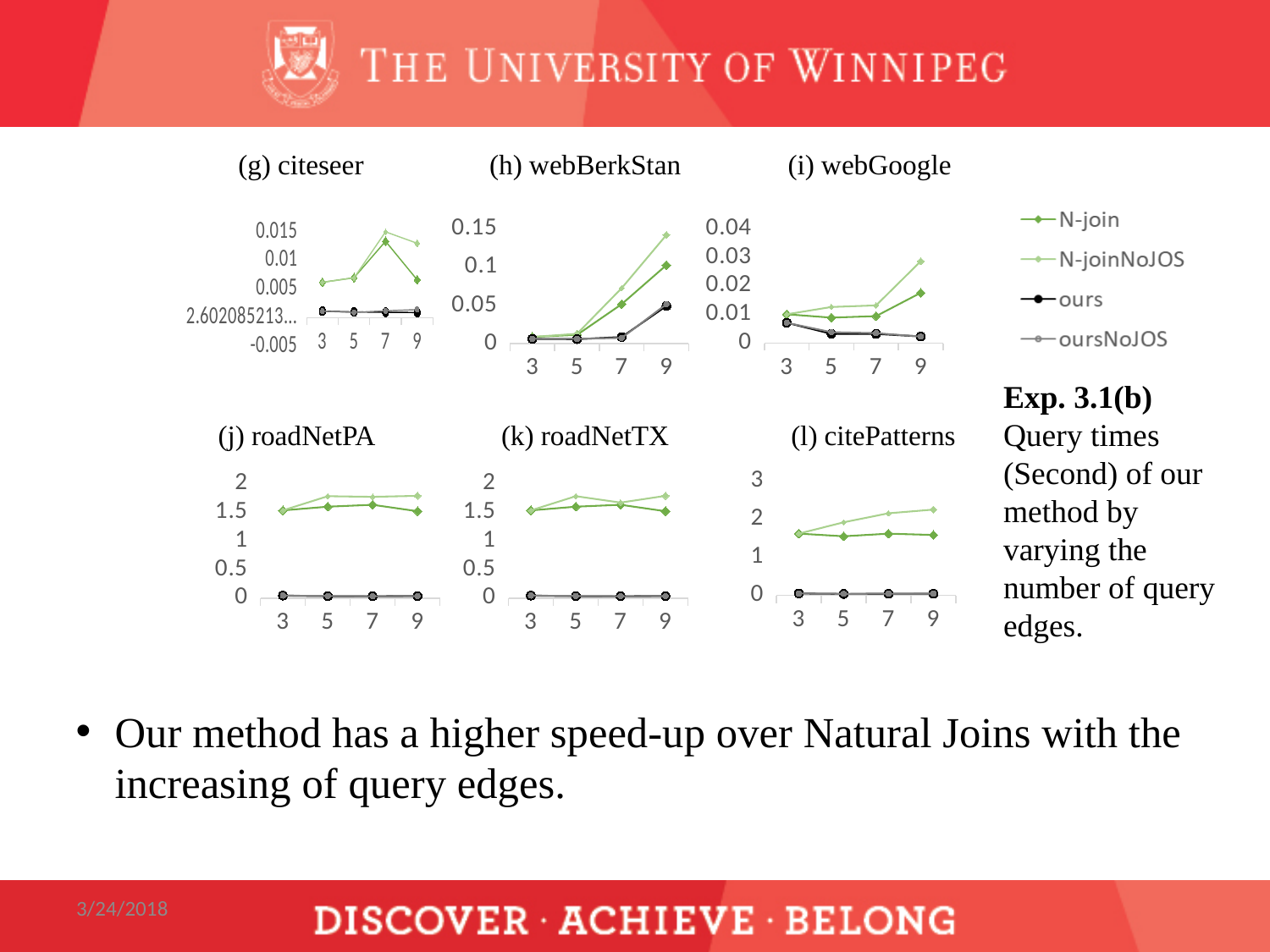
What kind of chart is (h) webBerkStan? line chart In (i) webGoogle, is the N-joinNoJOS value at 9 greater or less than 0.02? greater How many x-axis points are plotted in (j) roadNetPA? 4 In (j) roadNetPA, is the ours value at 5 greater or less than 0.5? less In (i) webGoogle, does the oursNoJOS series rise or fall from 3 to 9? fall In (h) webBerkStan, does the N-joinNoJOS series rise or fall from 3 to 9? rise In (h) webBerkStan, is the N-joinNoJOS value at 9 greater or less than 0.1? greater In (i) webGoogle, which series has the highest value at 9? N-joinNoJOS How many series does the legend list for these charts? 4 In (j) roadNetPA, at 9, which is higher: N-joinNoJOS or ours? N-joinNoJOS What is the title of the top-left chart? (g) citeseer